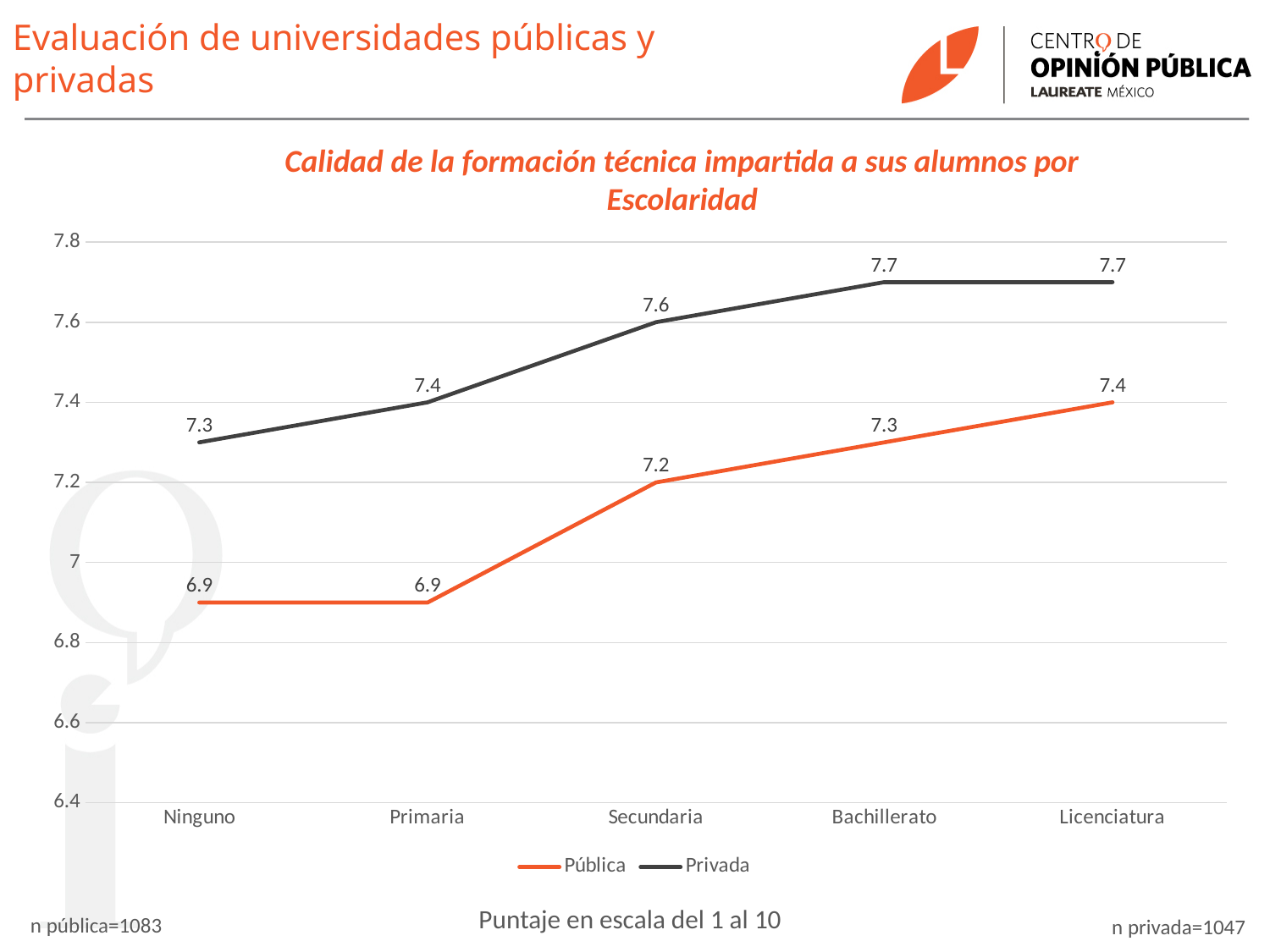
Does the Privada series rise or fall from Ninguno to Bachillerato? rise What is the value for Pública at Secundaria? 7.2 Which category has the lowest value for Privada? Ninguno What is the difference between Privada and Pública at Ninguno? 0.4 What is the difference between Pública at Licenciatura and Pública at Primaria? 0.5 What is the value for Pública at Licenciatura? 7.4 Is the value for Pública at Ninguno greater or less than 7? less What is the value for Privada at Primaria? 7.4 How many series does the legend list? 2 Which is larger at Bachillerato, Pública or Privada? Privada How many categories are shown on the x axis? 5 What kind of chart is shown? line chart